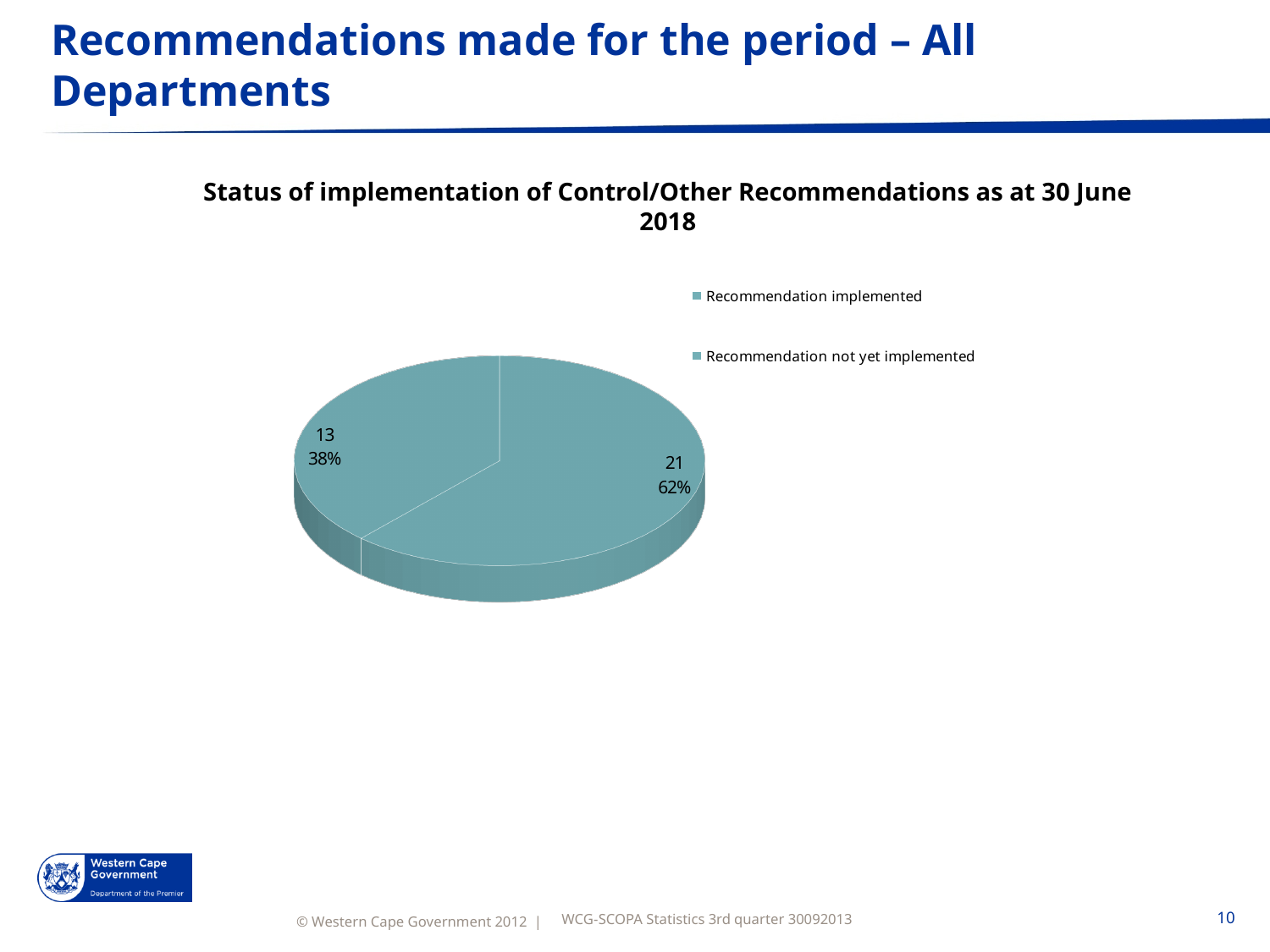
What is the total number of recommendations represented by the two slices of the pie chart? 34 How many entries does the legend of the pie chart list? 2 What are the two legend entries of the pie chart? Recommendation implemented; Recommendation not yet implemented What is the difference between the counts on the larger and smaller slices of the pie chart? 8 What percentage is shown on the smaller slice of the pie chart? 38% What percentage is shown on the larger slice of the pie chart? 62% What is the count shown on the larger slice of the pie chart? 21 How many slices does the pie chart have? 2 What is the title of the pie chart? Status of implementation of Control/Other Recommendations as at 30 June 2018 What is the count shown on the smaller slice of the pie chart? 13 What kind of chart is shown on the slide? Pie chart